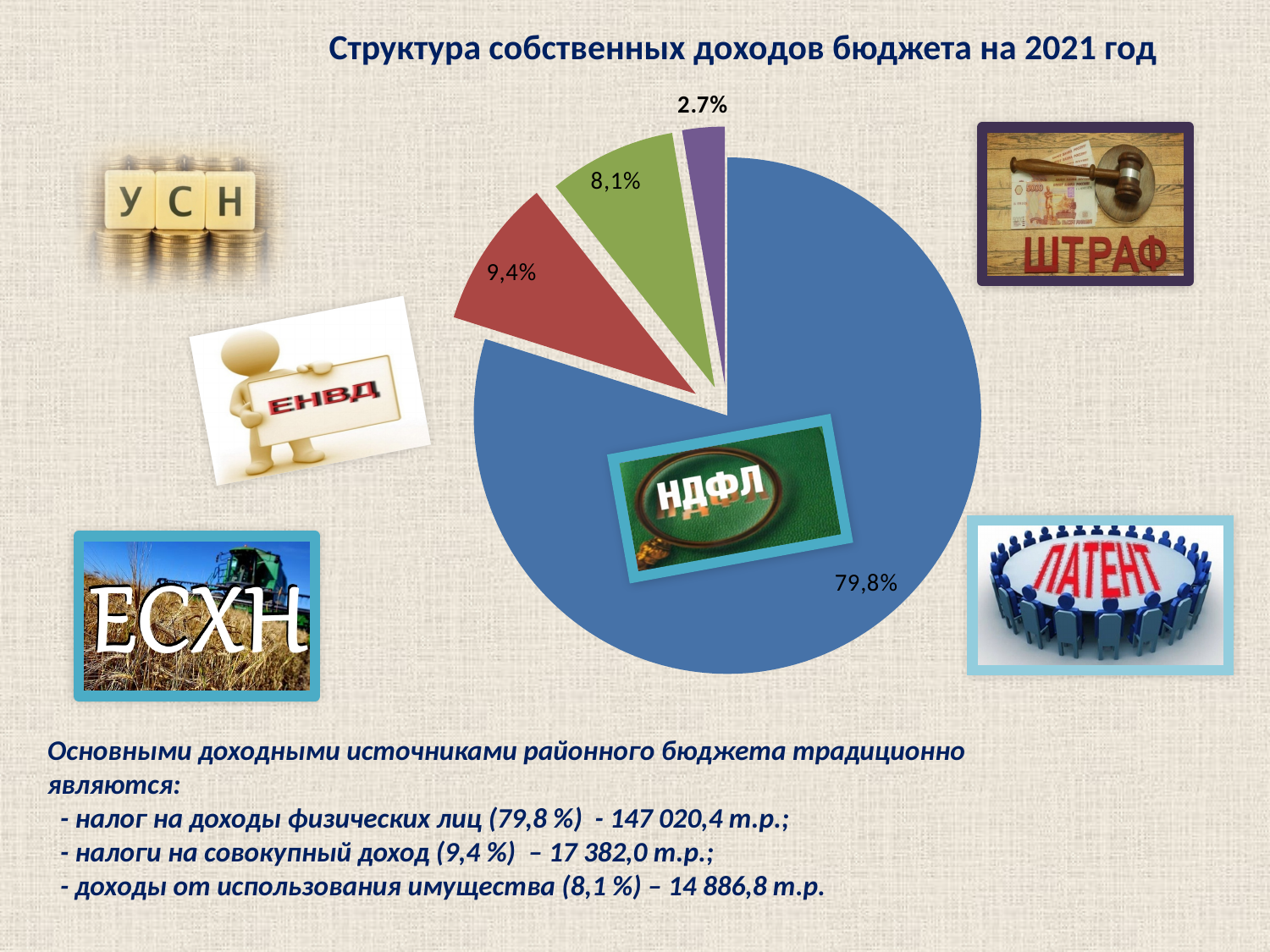
What value is labelled on the red slice of the pie chart? 9,4% How many slices does the pie chart have? 4 What value is labelled on the purple slice of the pie chart? 2.7% What is the value shown on the smallest slice of the pie chart? 2.7% Which slice is larger, the one labelled 9,4% or the one labelled 8,1%? 9,4% What is the value shown on the largest slice of the pie chart? 79,8% What is the title of the chart? Структура собственных доходов бюджета на 2021 год What colour is the slice labelled 79,8%? blue According to the slide, what share of the budget's own revenues comes from налог на доходы физических лиц? 79,8% What value is labelled on the green slice of the pie chart? 8,1% What kind of chart is shown on the slide? pie chart What is the difference in percentage points between the 9,4% slice and the 8,1% slice? 1,3